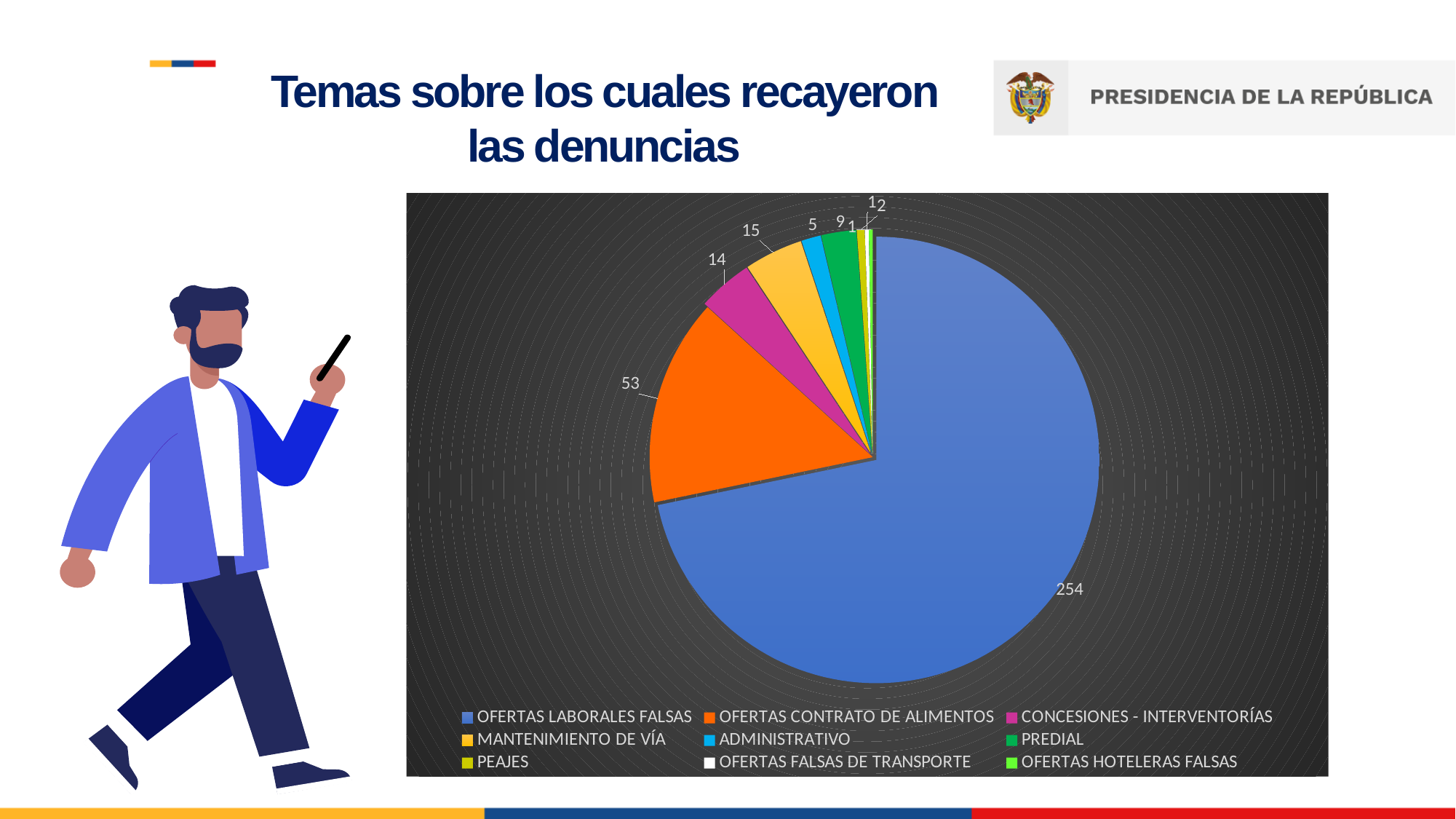
What is the value for CONCESIONES - INTERVENTORÍAS? 14 What colour is the slice for OFERTAS CONTRATO DE ALIMENTOS? orange How many categories does the pie chart show? 9 Which category has the largest slice of the pie? OFERTAS LABORALES FALSAS What is the value for PREDIAL? 9 What is the value for OFERTAS LABORALES FALSAS? 254 What is the difference between the values for OFERTAS LABORALES FALSAS and OFERTAS CONTRATO DE ALIMENTOS? 201 What is the value for MANTENIMIENTO DE VÍA? 15 Which is larger, the value for MANTENIMIENTO DE VÍA or the value for CONCESIONES - INTERVENTORÍAS? MANTENIMIENTO DE VÍA What kind of chart is shown on the slide? pie chart What is the value for OFERTAS CONTRATO DE ALIMENTOS? 53 What is the value for ADMINISTRATIVO? 5